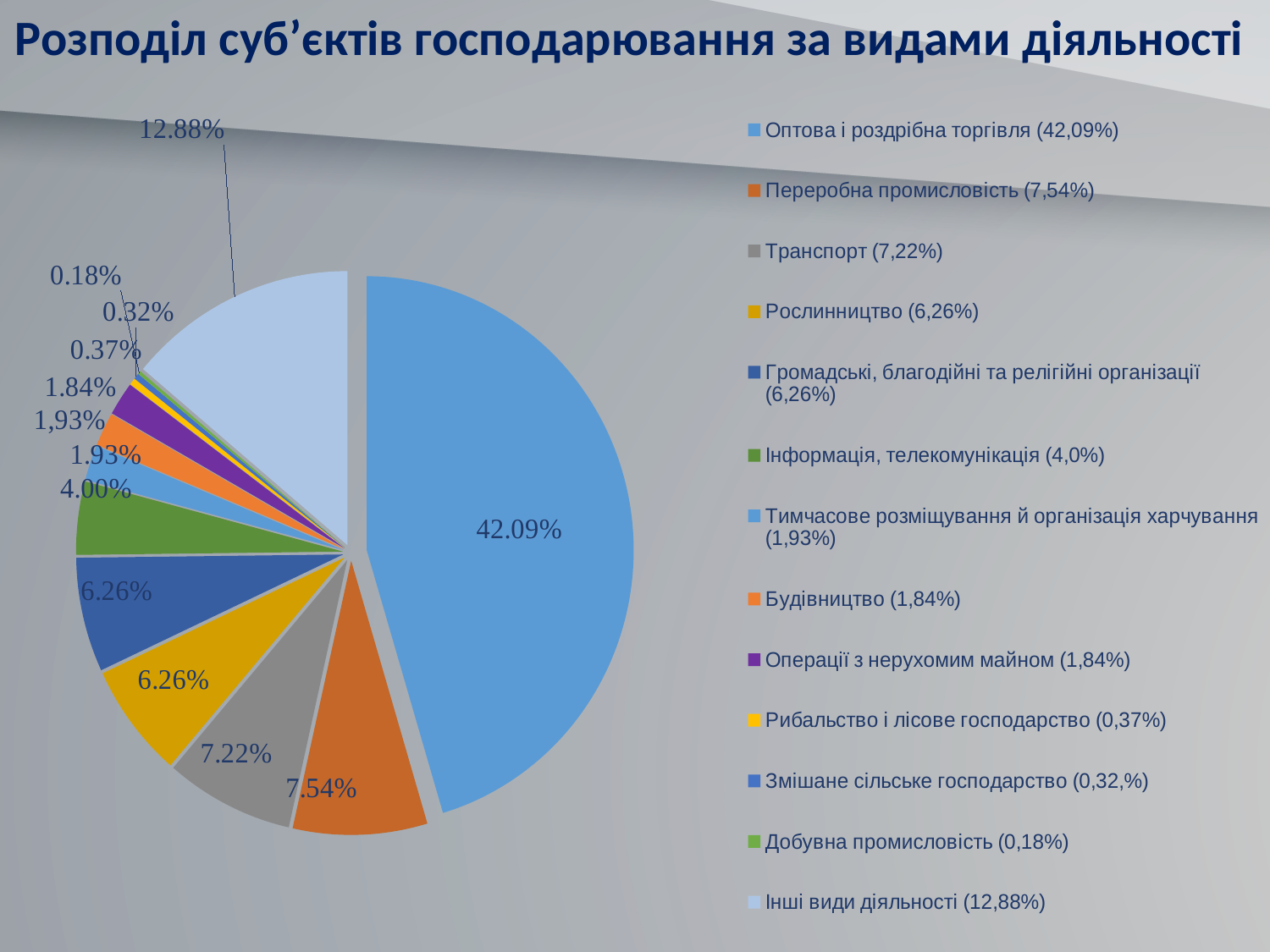
What is the value shown for Транспорт? 7.22% What share of the pie does Оптова і роздрібна торгівля have? 42.09% How many categories does the legend of the pie chart list? 13 What is the value shown for Переробна промисловість? 7.54% What is the value shown for Інші види діяльності? 12.88% Which category has the largest slice of the pie? Оптова і роздрібна торгівля Which is larger, the share for Переробна промисловість or the share for Транспорт? Переробна промисловість What is the title of the chart? Розподіл суб'єктів господарювання за видами діяльності Which category has the smallest slice of the pie? Добувна промисловість What is the value shown for Добувна промисловість? 0.18% What type of chart is shown on the slide? Pie chart What is the difference between the share for Оптова і роздрібна торгівля and the share for Інші види діяльності? 29.21 percentage points